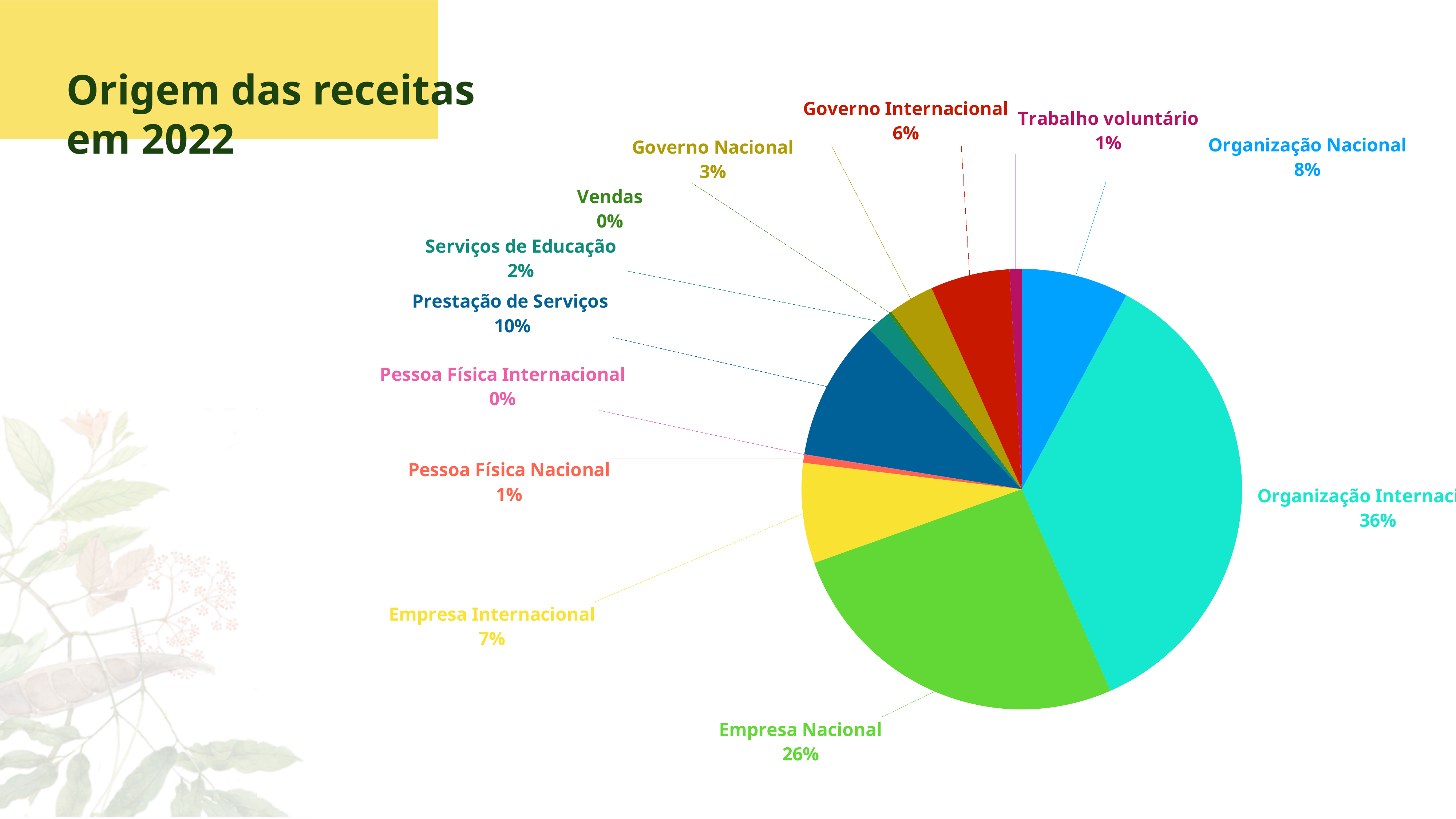
What is the difference in percentage points between Empresa Nacional and Empresa Internacional? 19% What is the title of the chart on the slide? Origem das receitas em 2022 How many categories are shown in the pie chart? 12 What kind of chart is shown on the slide? Pie chart Which category has the largest slice of the pie? Organização Internacional Which is larger, Governo Nacional or Governo Internacional? Governo Internacional What percentage is shown for Prestação de Serviços? 10% What share of revenue comes from Empresa Nacional? 26% What percentage is shown for Governo Internacional? 6% What percentage is shown for Organização Nacional? 8% What percentage is shown for Serviços de Educação? 2% What percentage is shown for Trabalho voluntário? 1%